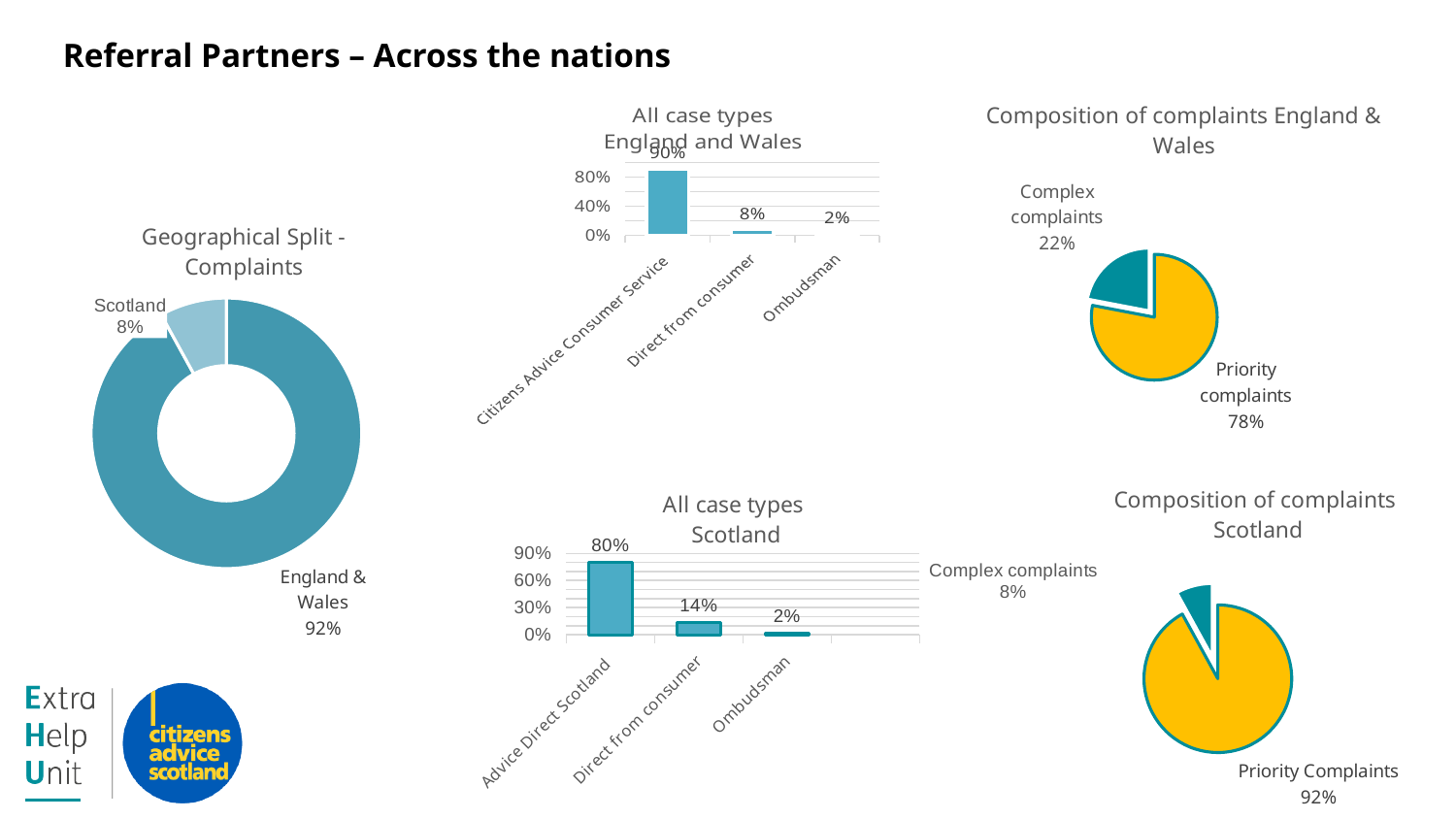
In the 'Composition of complaints England & Wales' chart, what share is Complex complaints? 22% In the 'All case types England and Wales' chart, what is the value for Citizens Advice Consumer Service? 90% In the 'Composition of complaints Scotland' chart, what share is Priority Complaints? 92% Which is larger: Complex complaints in the 'Composition of complaints England & Wales' chart or Complex complaints in the 'Composition of complaints Scotland' chart? England & Wales In the 'All case types Scotland' chart, what is the value for Direct from consumer? 14% In the 'Geographical Split - Complaints' chart, what share of complaints comes from England & Wales? 92% In the 'All case types Scotland' chart, which category has the highest value? Advice Direct Scotland How many categories are shown in the 'All case types Scotland' chart? 3 In the 'All case types England and Wales' chart, which category has the lowest value? Ombudsman What kind of chart is 'All case types Scotland'? Bar chart In the 'Geographical Split - Complaints' chart, what share of complaints comes from Scotland? 8% In the 'All case types England and Wales' chart, what is the difference between Citizens Advice Consumer Service and Direct from consumer? 82%